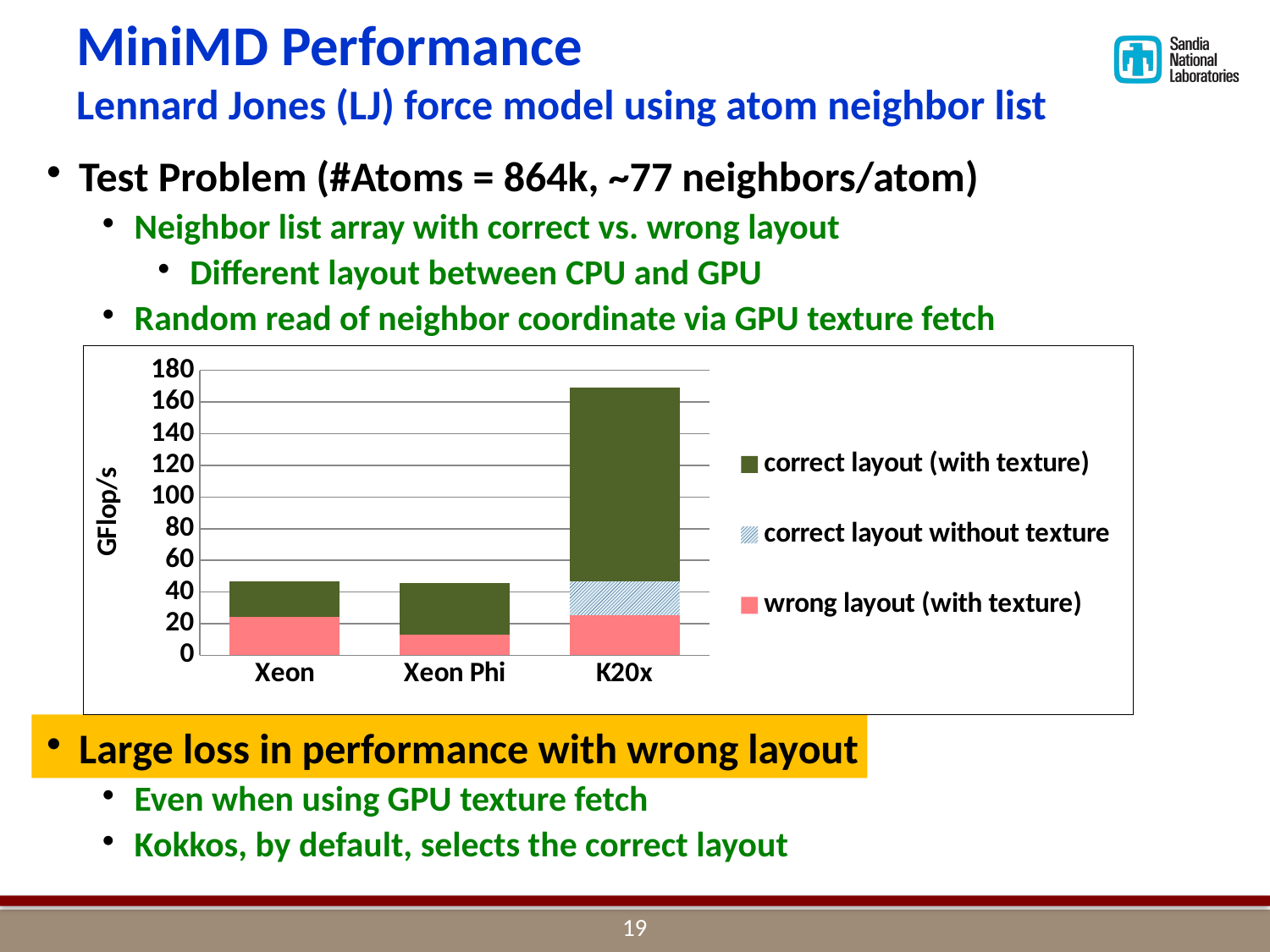
Which category has the lowest 'wrong layout (with texture)' value? Xeon Phi Which has the larger total bar, K20x or Xeon? K20x How many categories are shown on the x axis of the chart? 3 Which category has the highest total bar in the chart? K20x What is the label on the y axis of the chart? GFlop/s Which series in the legend is shown with a hatched pattern? correct layout without texture Is the 'wrong layout (with texture)' value for Xeon Phi greater or less than 20? less How many series does the chart's legend list? 3 Is the total bar for K20x greater or less than 140? greater What kind of chart is shown on the slide? Stacked bar chart Is the total bar for Xeon Phi greater or less than 60? less